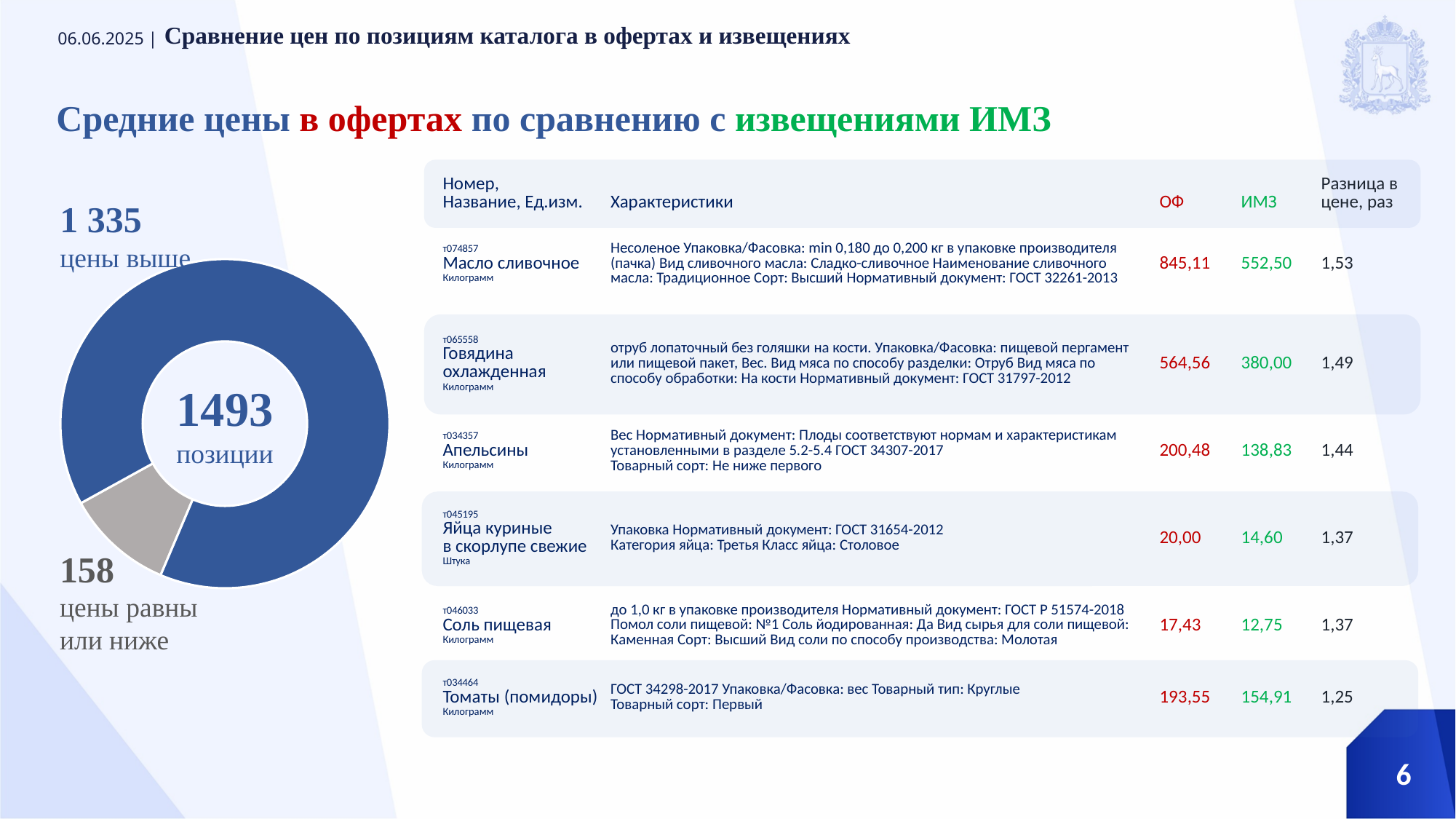
What word appears under the number 1493 in the centre of the donut chart? позиции Which is larger in the donut chart: "цены выше" or "цены равны или ниже"? цены выше Which segment of the donut chart is the smallest? цены равны или ниже What kind of chart is shown on the left of the slide? pie chart (donut) How many segments does the donut chart have? 2 What is the difference between the number of positions with "цены выше" and those with "цены равны или ниже"? 1 177 What colour is the larger segment of the donut chart? blue In the donut chart, how many positions are in the segment labelled "цены выше"? 1 335 In the donut chart, how many positions are in the segment labelled "цены равны или ниже"? 158 Which segment of the donut chart is the largest? цены выше What total number of positions is shown in the centre of the donut chart? 1493